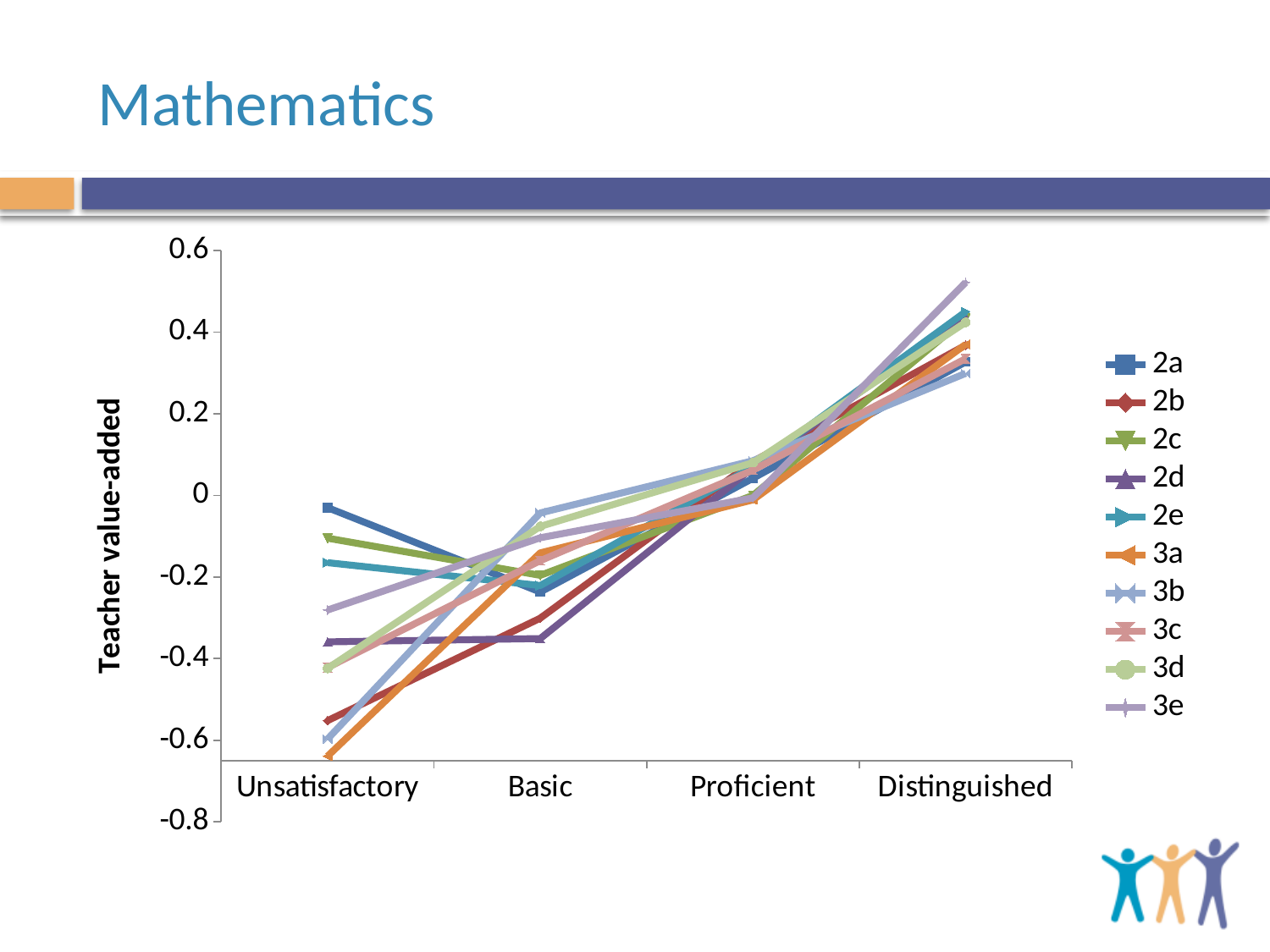
Does the value for 3e rise or fall from Unsatisfactory to Distinguished? rise Which series has the highest value at Unsatisfactory? 2a Is the value for 2d at Basic greater or less than -0.2? less How many series does the legend list? 10 Is the value for 3a at Unsatisfactory greater or less than -0.6? less Which series has the highest value at Distinguished? 3e How many categories are shown on the x axis? 4 What is the label of the y axis? Teacher value-added What kind of chart is shown on the slide? line chart What is the title of the slide containing the chart? Mathematics At Distinguished, which is larger: the value for 3e or the value for 3b? 3e Is the value for 3e at Distinguished greater or less than 0.4? greater